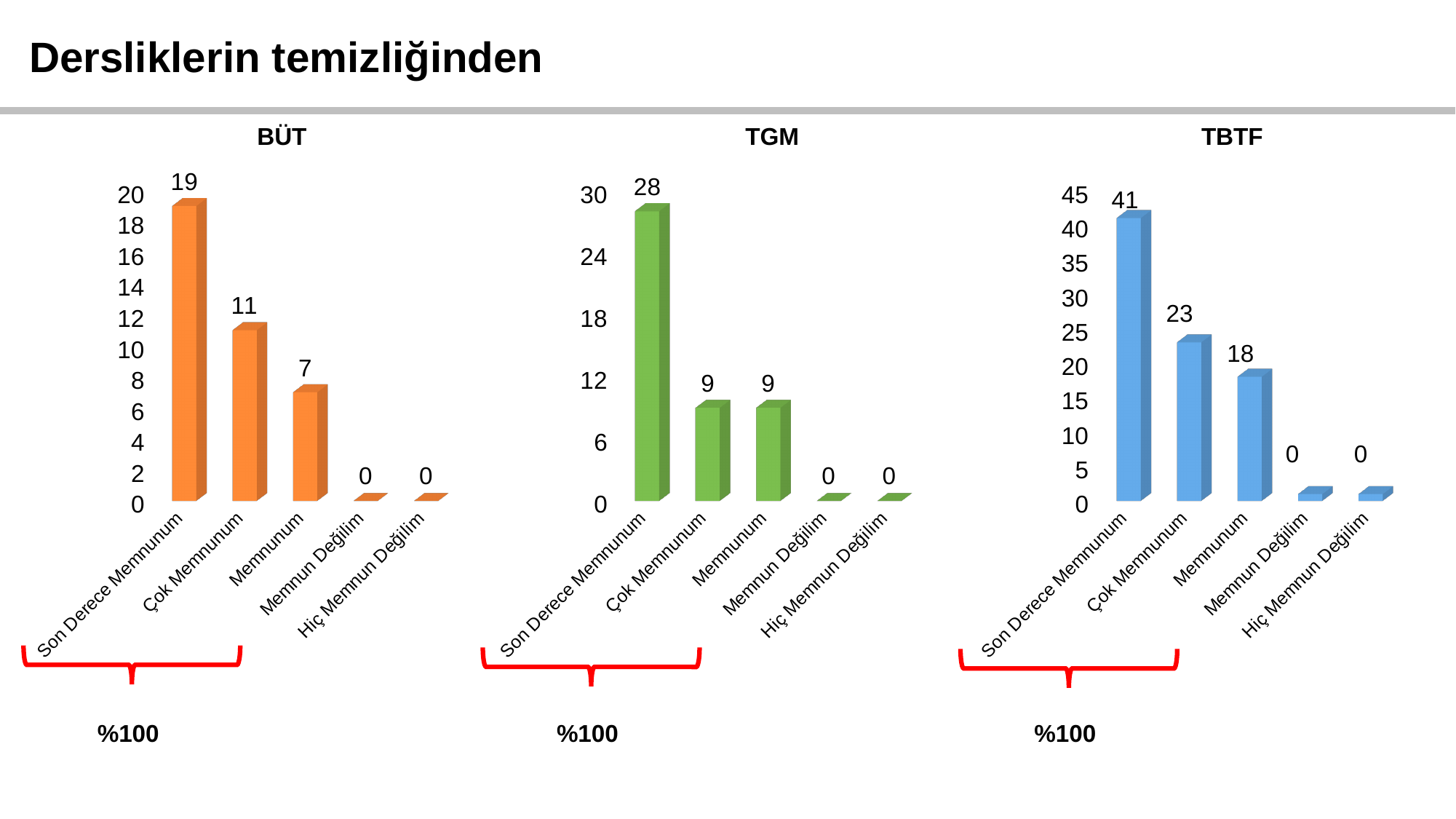
In the TBTF chart, what is the difference between Çok Memnunum and Memnunum? 5 In the BÜT chart, what is the difference between Son Derece Memnunum and Çok Memnunum? 8 In the TGM chart, which is larger, Son Derece Memnunum or Memnunum? Son Derece Memnunum In the TGM chart, what is the value for Hiç Memnun Değilim? 0 In the TBTF chart, what is the value for Memnunum? 18 How many categories does the BÜT chart show? 5 In the BÜT chart, what is the value for Son Derece Memnunum? 19 In the TBTF chart, which category has the highest value? Son Derece Memnunum What kind of chart is the TGM chart? bar chart In the TBTF chart, do the values rise or fall from left to right across the categories? fall What colour are the bars in the TBTF chart? blue In the TGM chart, what is the value for Çok Memnunum? 9